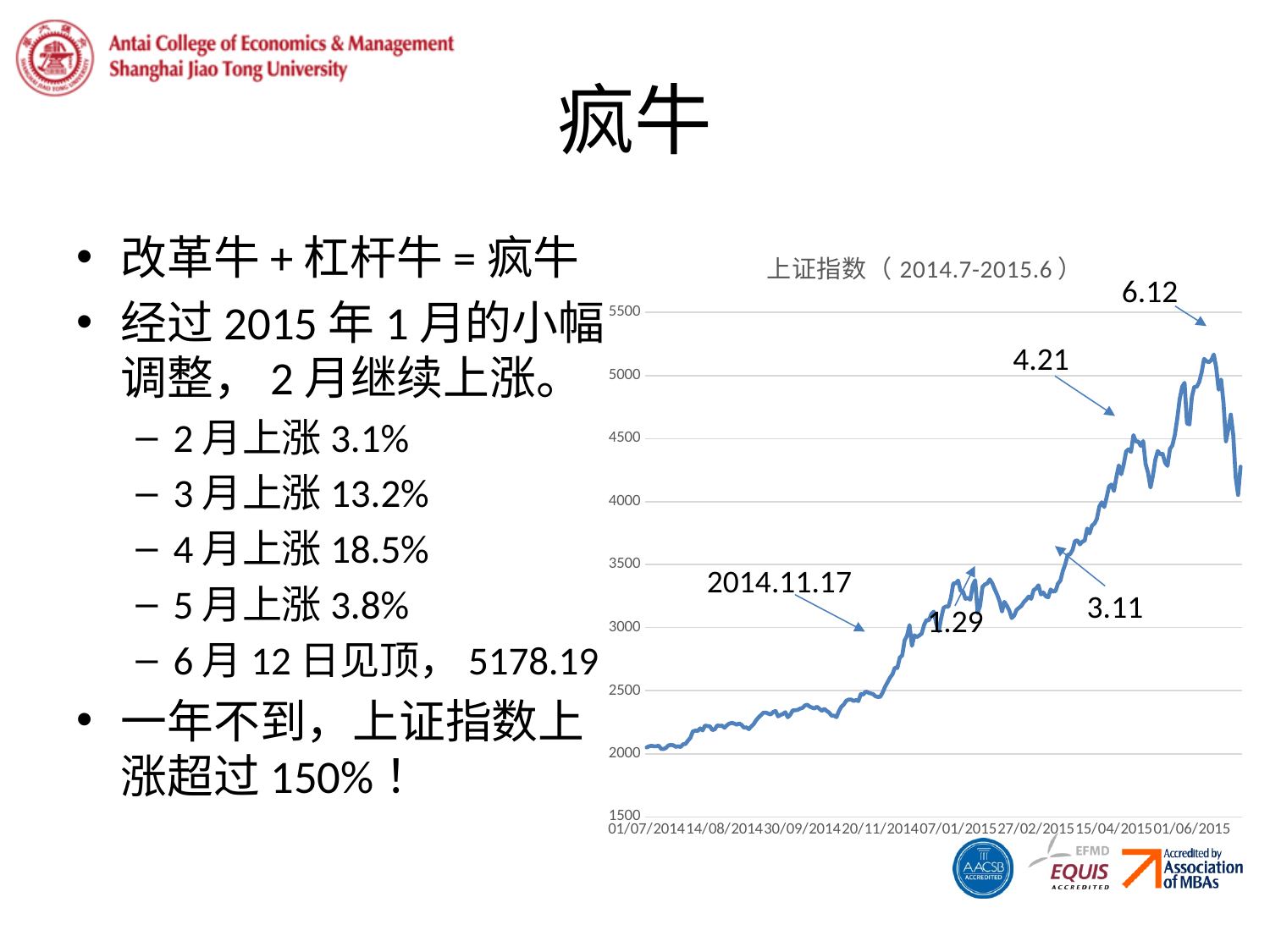
Is the index value at the point labelled 4.21 greater or less than 4000? greater Which annotated date on the chart marks the highest point of the index? 6.12 Is the index value at the point labelled 2014.11.17 greater or less than 3500? less What is the lowest value shown on the chart's vertical axis? 1500 What is the title of the chart? 上证指数（2014.7-2015.6） Is the peak of the index in the chart greater or less than 5000? greater Is the index value at the point labelled 1.29 higher or lower than at the point labelled 4.21? lower How many dates are annotated with arrows on the chart? 5 Does the index generally rise or fall from July 2014 to June 2015 in the chart? rise What kind of chart is shown on the slide? line chart